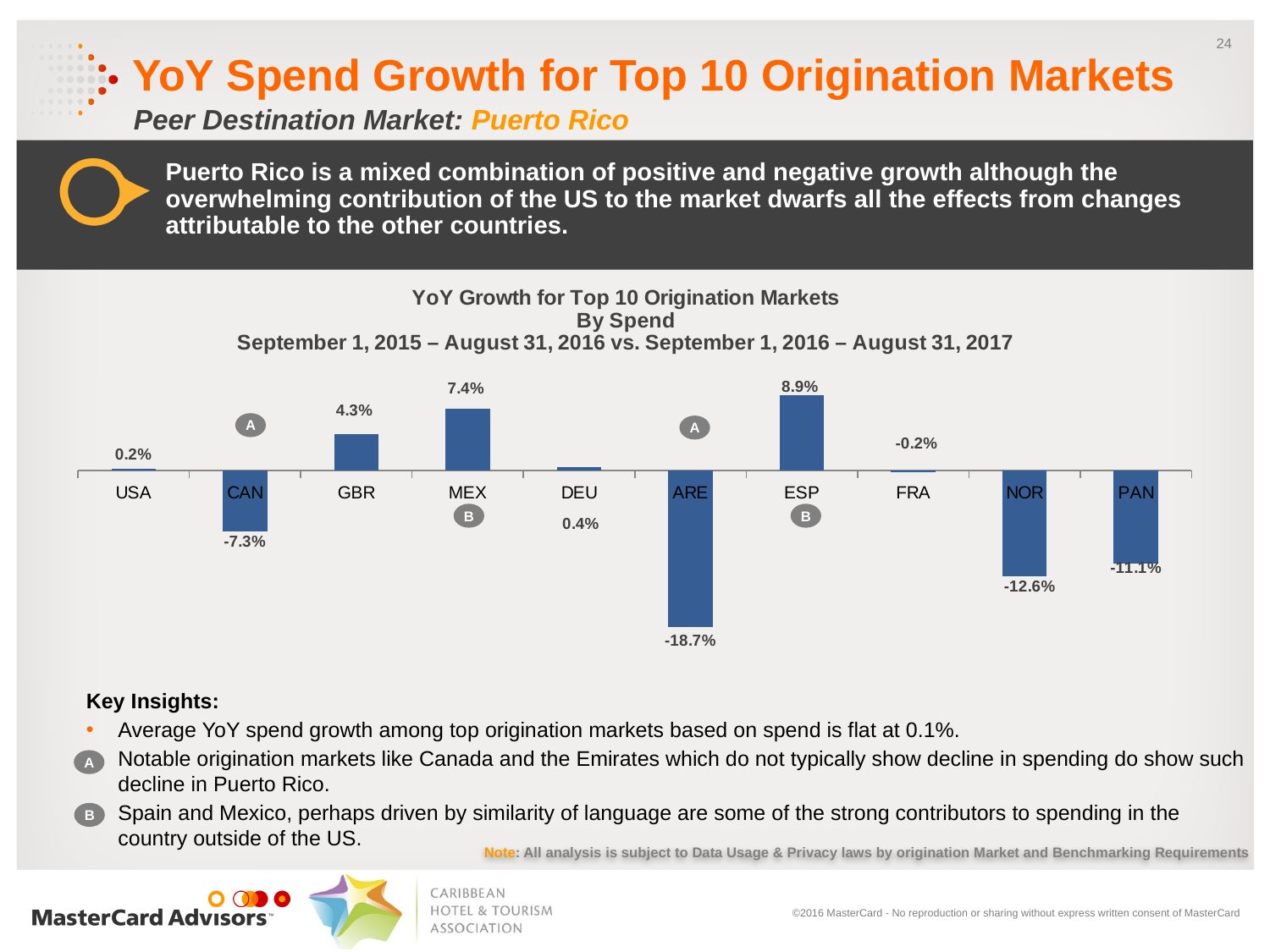
Which has a larger YoY spend growth, GBR or MEX? MEX What type of chart is used to show YoY growth for the top 10 origination markets? Bar chart What is the YoY spend growth value for ARE? -18.7% What is the YoY spend growth value for NOR? -12.6% What is the YoY spend growth value for FRA? -0.2% What is the YoY spend growth value for ESP? 8.9% What is the YoY spend growth value for CAN? -7.3% Which origination market has the lowest YoY spend growth? ARE Which origination market has the highest YoY spend growth? ESP What is the title of the chart? YoY Growth for Top 10 Origination Markets By Spend How many origination markets are shown in the chart? 10 What is the difference between the YoY spend growth of ESP and MEX? 1.5%